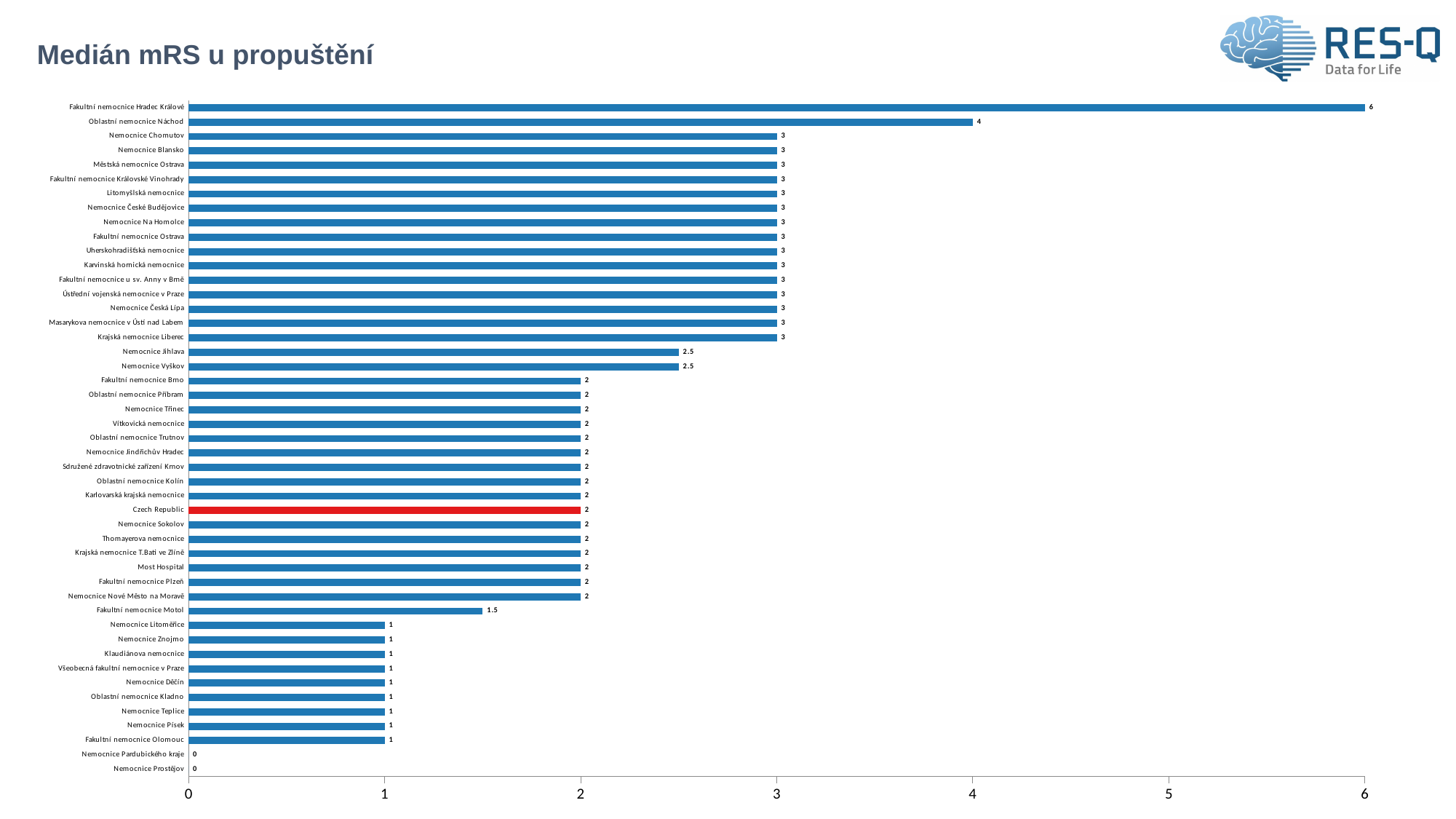
What value is shown for Czech Republic? 2 Which bar is highlighted in red? Czech Republic Which is larger, the value for Nemocnice Vyškov or the value for Fakultní nemocnice Brno? Nemocnice Vyškov What value is shown for Fakultní nemocnice Motol? 1.5 What value is shown for Nemocnice Prostějov? 0 What is the difference between the values for Fakultní nemocnice Hradec Králové and Oblastní nemocnice Náchod? 2 What type of chart is shown on the slide? Bar chart What is the median mRS at discharge for Fakultní nemocnice Hradec Králové? 6 What value is shown for Nemocnice Jihlava? 2.5 What value is shown for Oblastní nemocnice Náchod? 4 What is the title of the chart? Medián mRS u propuštění Which hospital has the highest median mRS at discharge? Fakultní nemocnice Hradec Králové